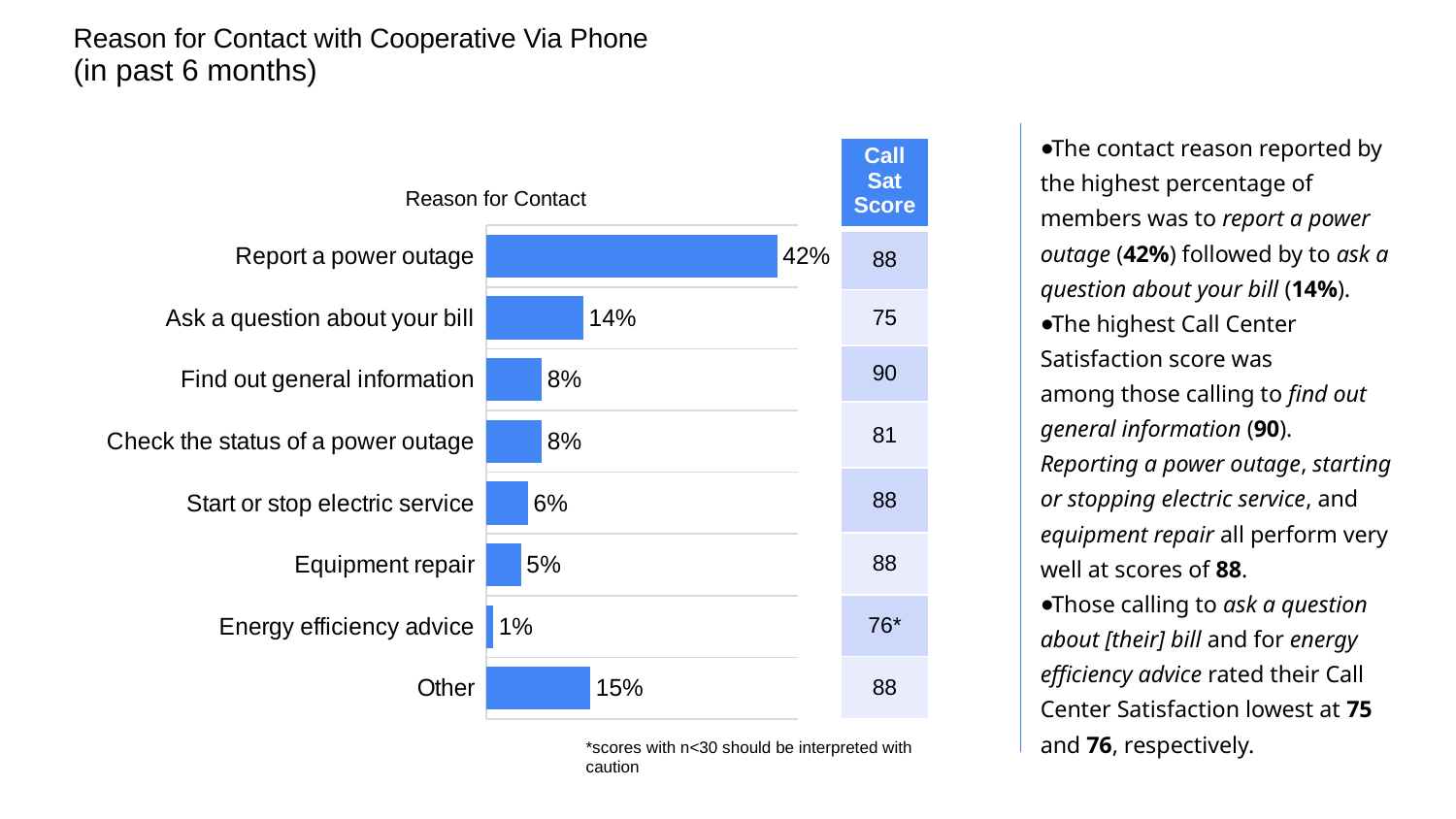
Which has a higher percentage: 'Other' or 'Ask a question about your bill'? Other How many reasons for contact are shown in the chart? 8 Which reason for contact has the lowest percentage? Energy efficiency advice Which reason for contact has the highest percentage? Report a power outage What percentage of members called to ask a question about their bill? 14% What is the Call Sat Score for 'Find out general information'? 90 What is the difference in percentage points between 'Report a power outage' and 'Ask a question about your bill'? 28 What is the Call Sat Score for 'Ask a question about your bill'? 75 What type of chart is used to show the reasons for contact? Bar chart What percentage of members called for energy efficiency advice? 1% What percentage of members contacted the cooperative by phone to report a power outage? 42% What is the title of the chart? Reason for Contact with Cooperative Via Phone (in past 6 months)